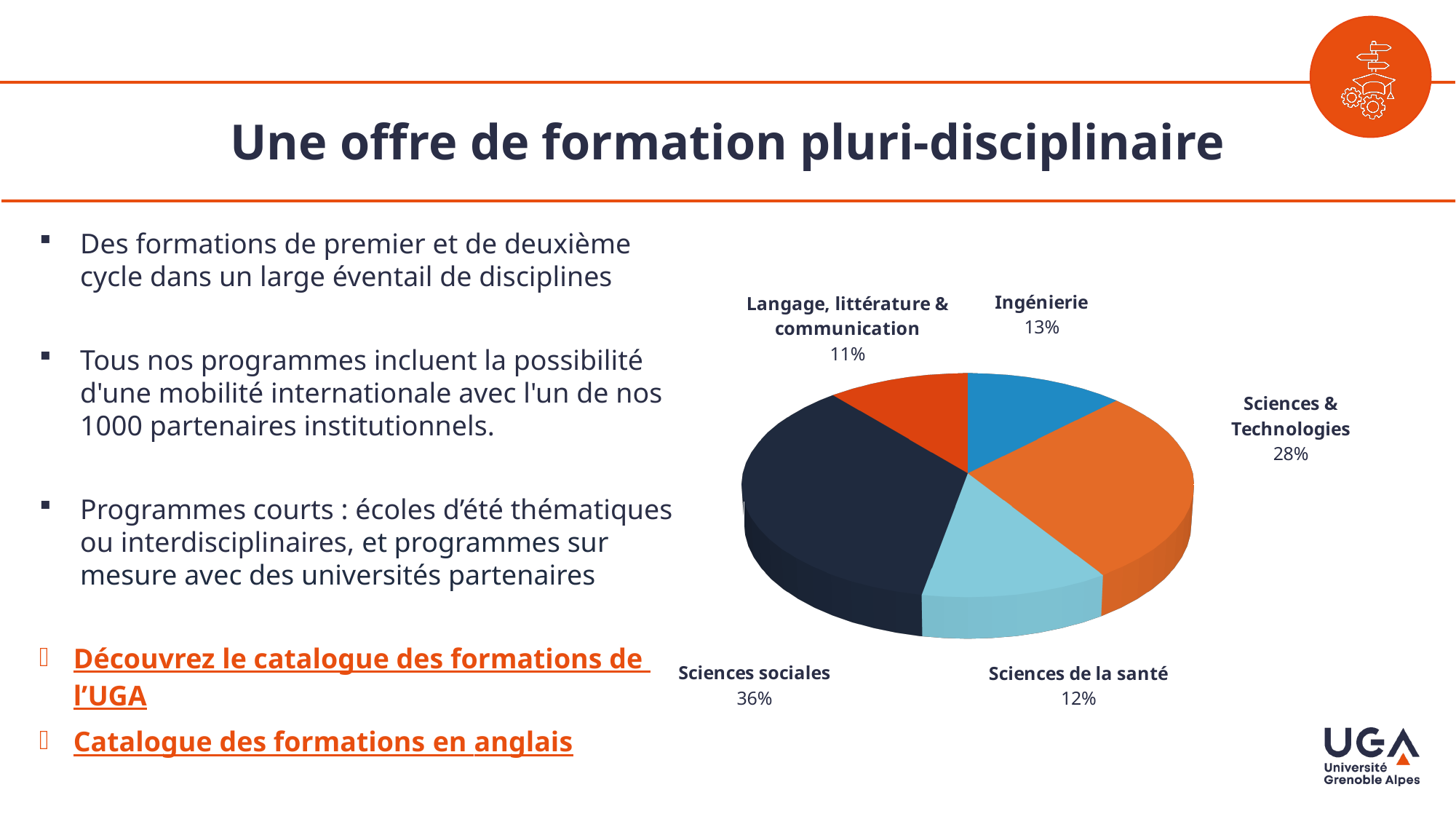
What colour is the Sciences sociales slice of the pie chart? Dark navy What share of the pie chart is Ingénierie? 13% Which category has the smallest slice of the pie chart? Langage, littérature & communication What is the difference in percentage points between Sciences sociales and Sciences & Technologies? 8 What share of the pie chart is Sciences de la santé? 12% Which category has the largest slice of the pie chart? Sciences sociales What share of the pie chart is Langage, littérature & communication? 11% What share of the pie chart is Sciences & Technologies? 28% How many categories are shown in the pie chart? 5 What share of the pie chart is Sciences sociales? 36% Which is larger, the share for Ingénierie or the share for Sciences de la santé? Ingénierie What kind of chart is shown on the slide? Pie chart